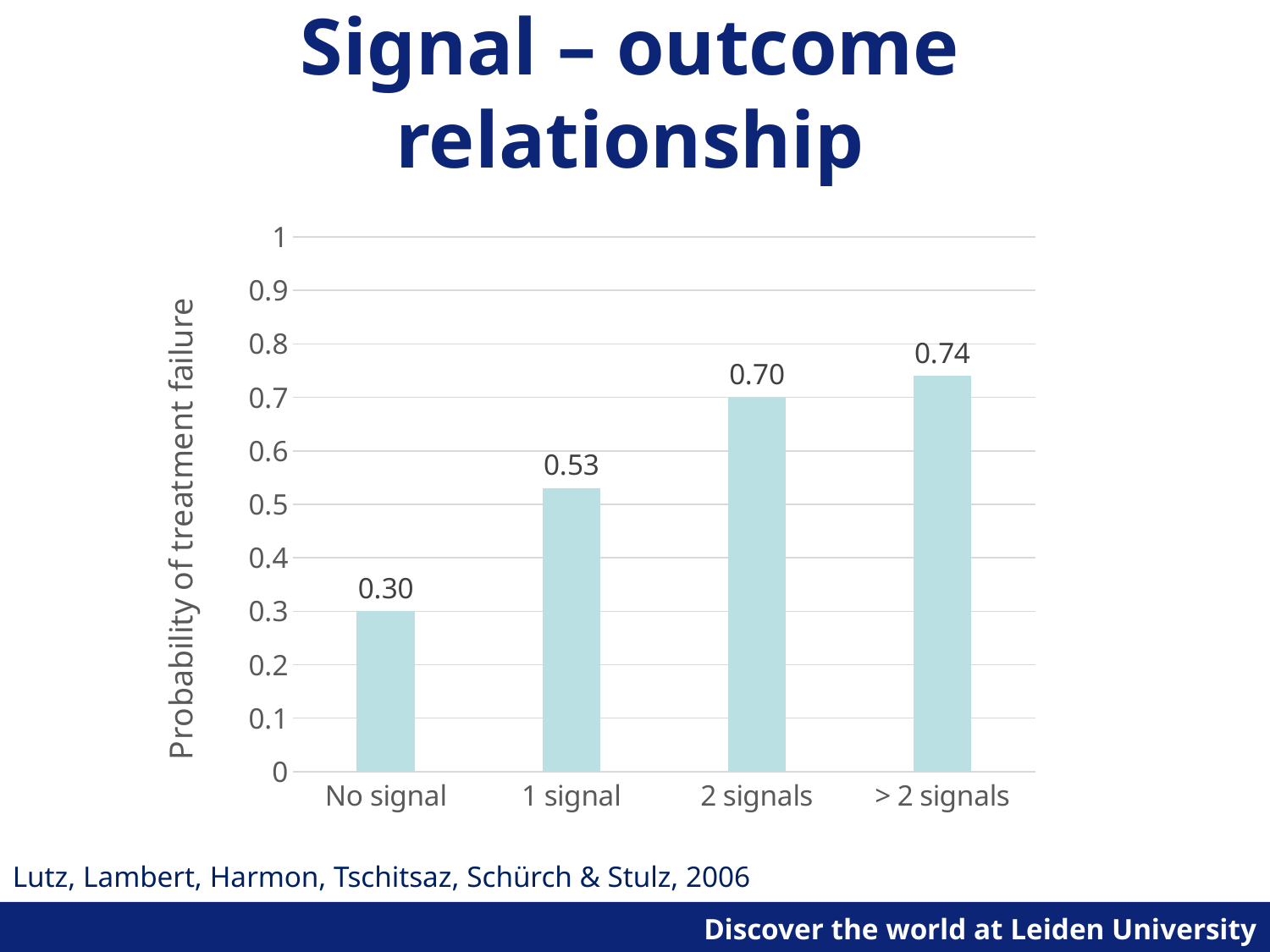
Which has a higher probability of treatment failure, '1 signal' or '2 signals'? 2 signals Which category has the highest probability of treatment failure? > 2 signals What is the probability of treatment failure for '2 signals'? 0.70 Do the values rise or fall as the number of signals increases along the x axis? Rise What is the difference in probability of treatment failure between '1 signal' and 'No signal'? 0.23 What is the probability of treatment failure for the 'No signal' category? 0.30 What is the probability of treatment failure for '> 2 signals'? 0.74 Which category has the lowest probability of treatment failure? No signal What is the difference in probability of treatment failure between '> 2 signals' and '2 signals'? 0.04 What is the probability of treatment failure for '1 signal'? 0.53 What kind of chart is shown on the slide? Bar chart How many categories are shown on the x axis? 4